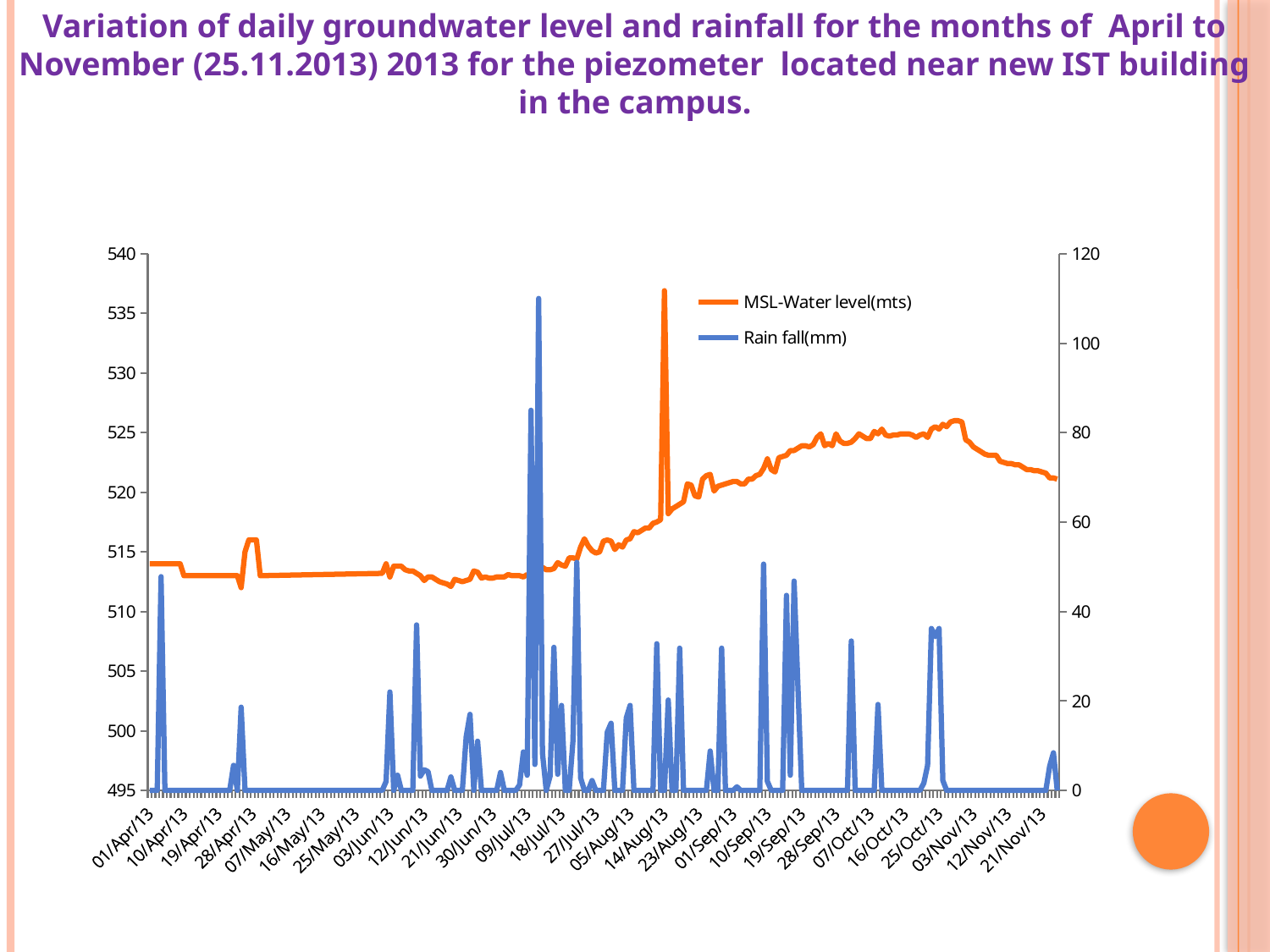
Is the MSL-Water level on 01/Apr/13 greater or less than 520? less Is the MSL-Water level higher on 07/Oct/13 or on 01/Sep/13? 07/Oct/13 What are the two series named in the legend? MSL-Water level(mts) and Rain fall(mm) Is the MSL-Water level on 07/Oct/13 greater or less than 520? greater What kind of chart is shown on the slide? line chart Is the tallest Rain fall peak greater or less than 100 on the right axis? greater What is the highest value shown on the right-hand vertical axis? 120 Does the MSL-Water level rise or fall between 09/Jul/13 and 07/Oct/13? rise How many series does the legend list? 2 Does the MSL-Water level rise or fall between 16/Oct/13 and 21/Nov/13? fall Is the MSL-Water level higher on 01/Apr/13 or on 21/Nov/13? 21/Nov/13